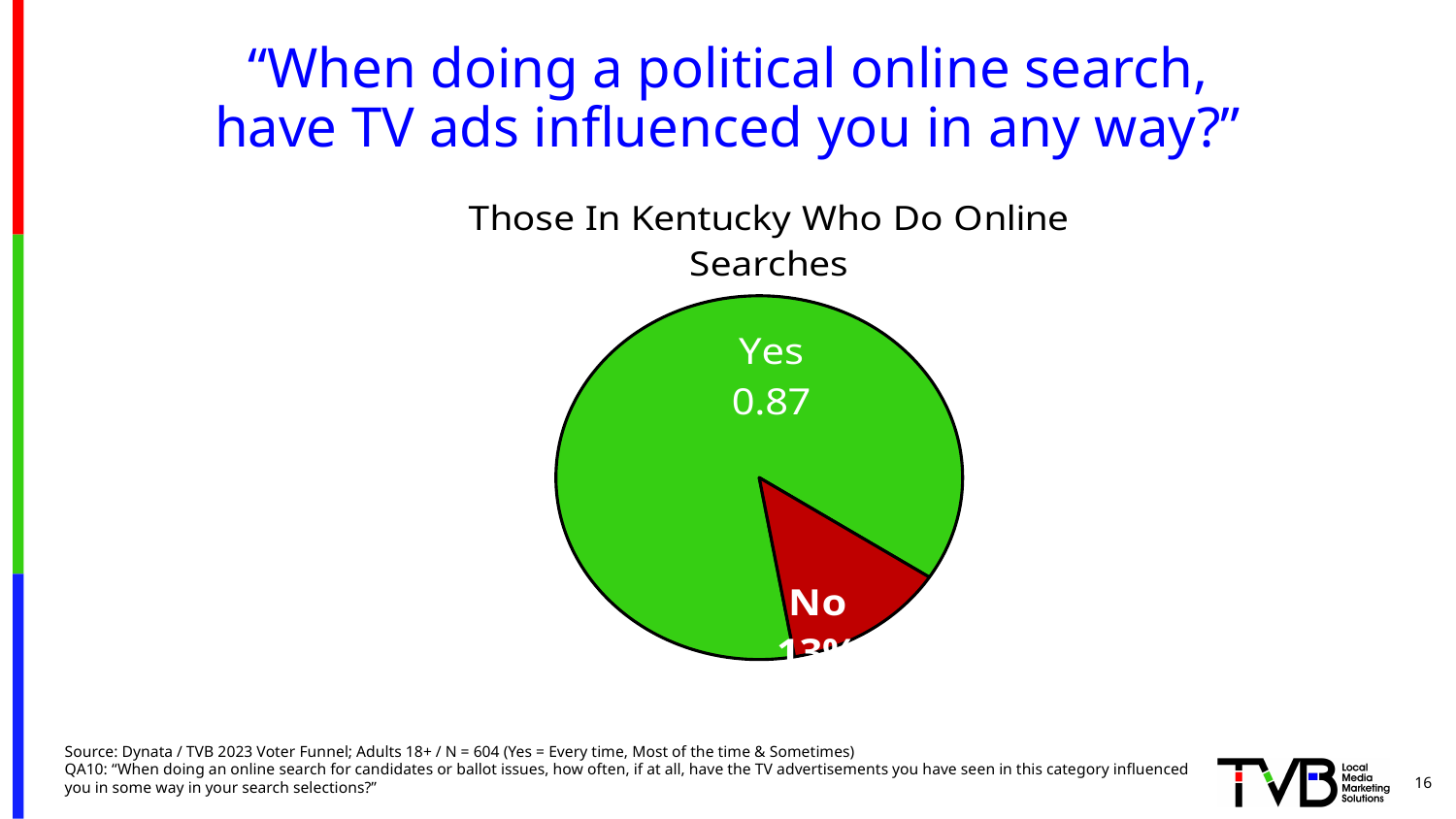
What share of the pie does the Yes slice represent, as labelled? 0.87 How many slices does the pie chart have? 2 What kind of chart is shown on the slide? Pie chart Which slice of the pie chart is the largest? Yes Which slice of the pie chart is the smallest? No What is the title of the pie chart? Those In Kentucky Who Do Online Searches What value is shown for the Yes slice of the pie chart? 0.87 What colour is the Yes slice of the pie chart? Green Which is larger in the pie chart, the Yes slice or the No slice? Yes